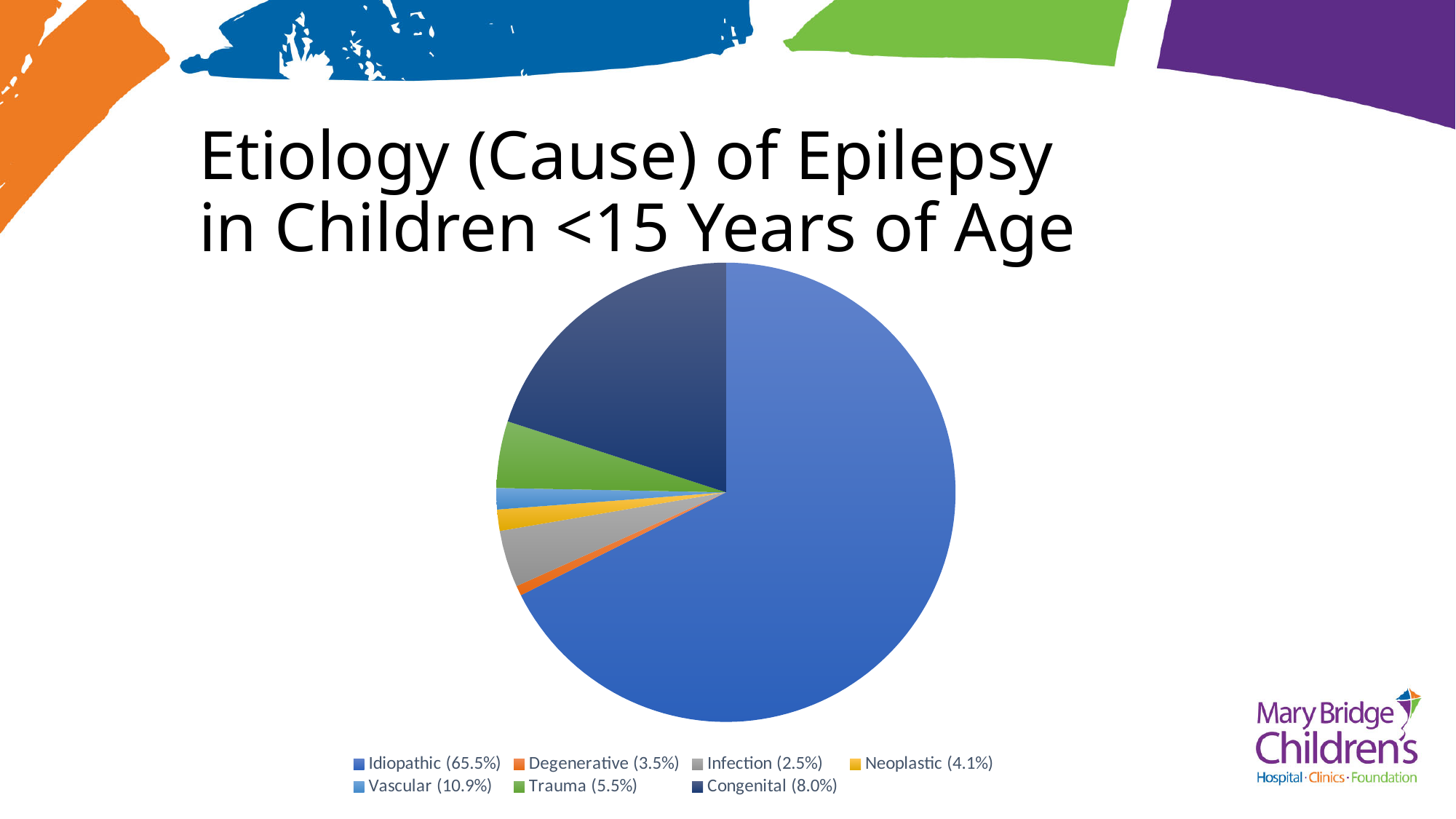
Which category is shown in orange in the legend? Degenerative What percentage is shown for Vascular in the legend? 10.9% What is the title of the slide containing the pie chart? Etiology (Cause) of Epilepsy in Children <15 Years of Age Which is larger, the share for Idiopathic or the share for Congenital? Idiopathic What percentage is shown for Neoplastic in the legend? 4.1% What is the difference in percentage points between Degenerative (3.5%) and Infection (2.5%)? 1.0% What share of the pie does Idiopathic account for? 65.5% How many categories does the pie chart have? 7 What percentage is shown for Trauma in the legend? 5.5% What percentage is shown for Congenital in the legend? 8.0% Which category has the largest share of the pie? Idiopathic What kind of chart is shown on the slide? pie chart